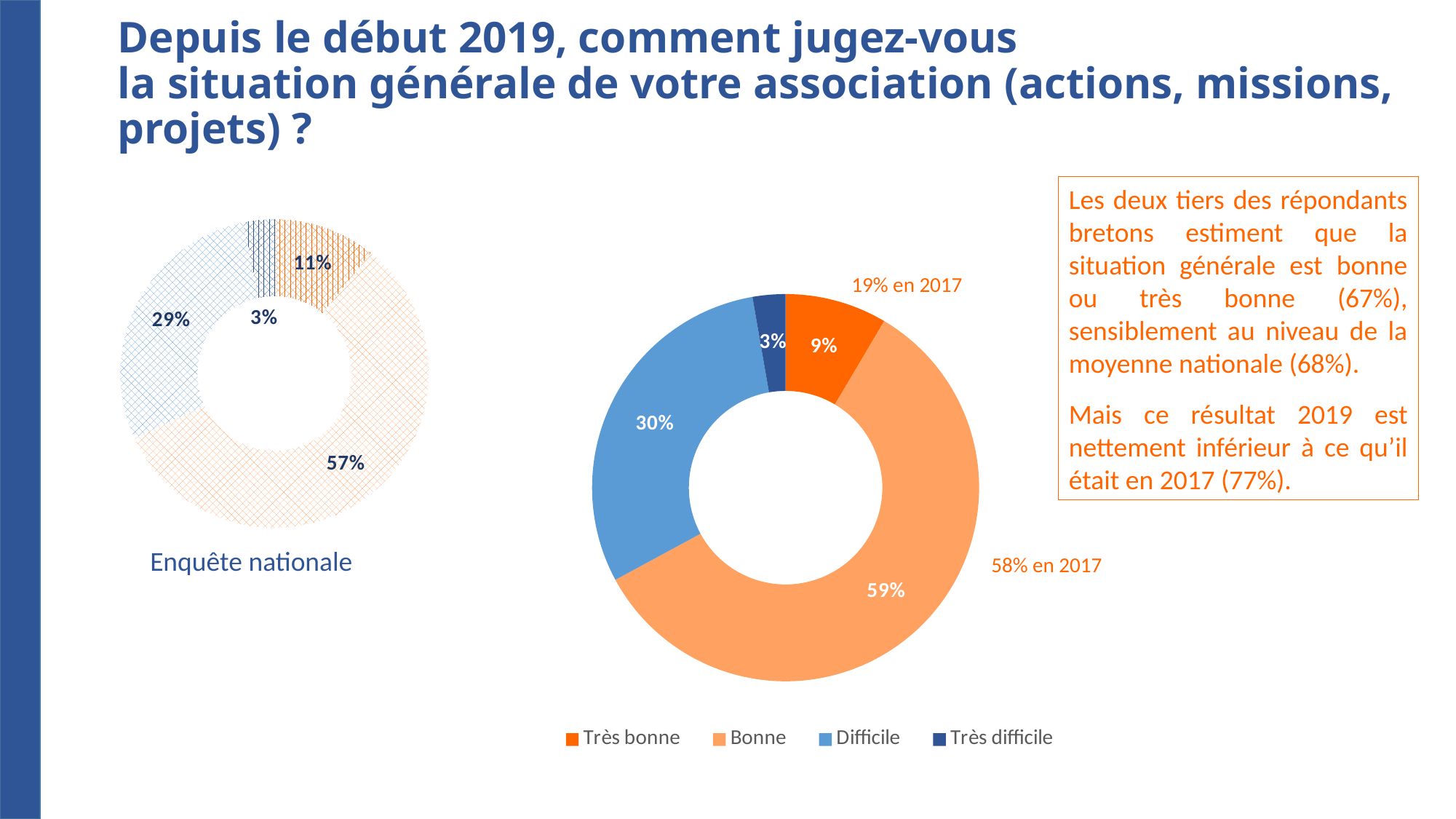
In the large central pie chart, which category has the smallest share? Très difficile In the large central pie chart, what share is labelled for 'Très bonne'? 9% In the large central pie chart, which is larger: the share for 'Difficile' or the share for 'Très bonne'? Difficile In the 'Enquête nationale' pie chart on the left, what is the largest share labelled? 57% In the large central pie chart, what share is labelled for 'Difficile'? 30% In the large central pie chart, which category has the largest share? Bonne In the large central pie chart, what was the share for 'Très bonne' in 2017, according to the annotation? 19% What kind of chart is the large chart in the centre of the slide? Pie chart (donut) In the large central pie chart, what share is labelled for 'Très difficile'? 3% In the large central pie chart, what is the difference between the shares for 'Bonne' and 'Difficile'? 29 percentage points How many categories does the legend of the large central pie chart list? 4 In the large central pie chart, what share is labelled for 'Bonne'? 59%